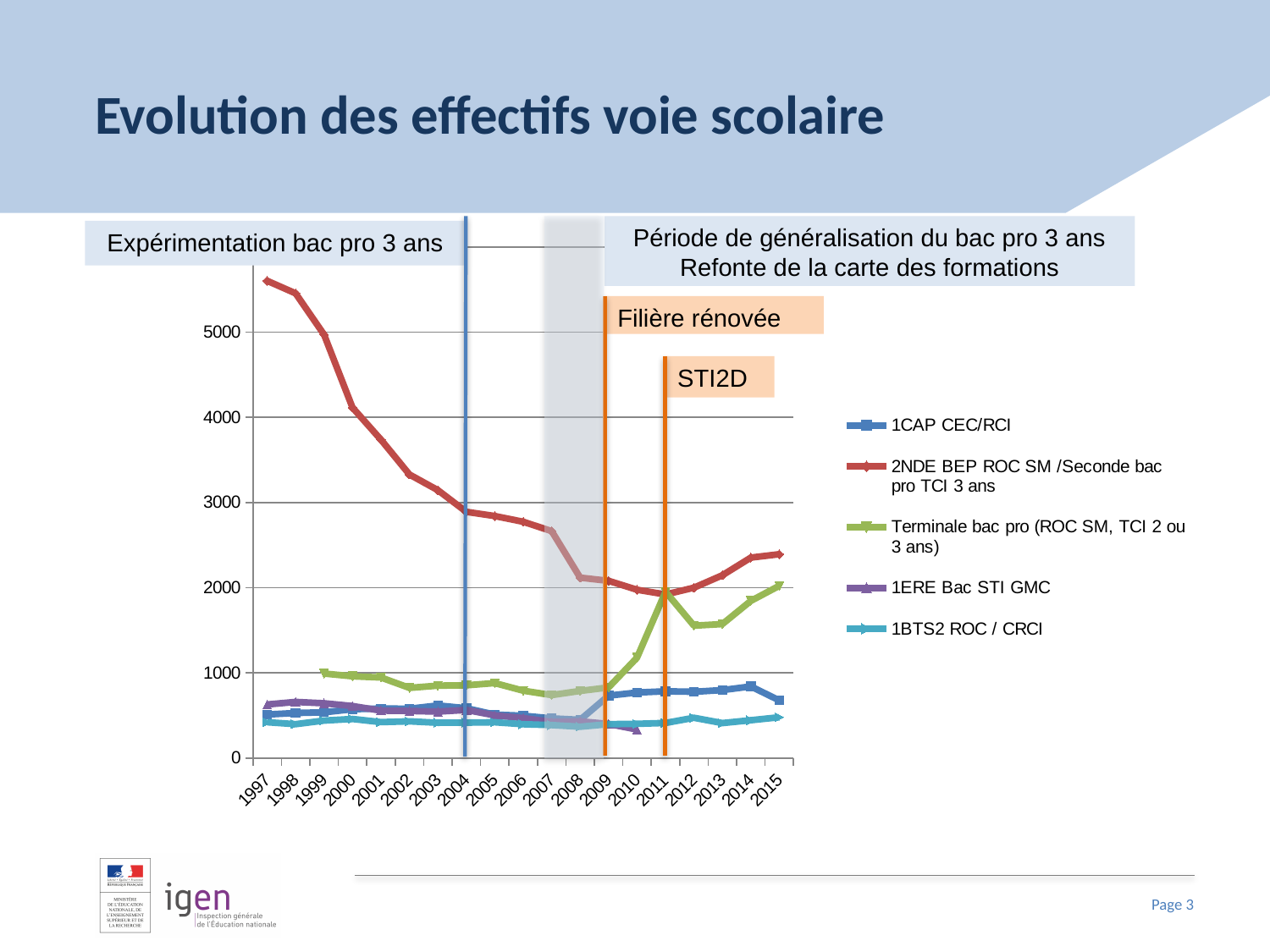
Is the value for 2NDE BEP ROC SM /Seconde bac pro TCI 3 ans in 2002 greater or less than 3000? greater In which year does the 2NDE BEP ROC SM /Seconde bac pro TCI 3 ans series reach its highest value? 1997 Is the value for 2NDE BEP ROC SM /Seconde bac pro TCI 3 ans in 1997 greater or less than 5000? greater How many series does the chart legend list? 5 Which legend entry is drawn in purple? 1ERE Bac STI GMC Which series has the highest value in 1997? 2NDE BEP ROC SM /Seconde bac pro TCI 3 ans Does the 2NDE BEP ROC SM /Seconde bac pro TCI 3 ans series rise or fall between 1997 and 2011? fall How many years are shown along the x axis of the chart? 19 Is the value for Terminale bac pro (ROC SM, TCI 2 ou 3 ans) in 2012 greater or less than 2000? less What kind of chart is shown on the slide? line chart In 2013, which is higher: Terminale bac pro (ROC SM, TCI 2 ou 3 ans) or 1CAP CEC/RCI? Terminale bac pro (ROC SM, TCI 2 ou 3 ans) What is the title of the slide containing the chart? Evolution des effectifs voie scolaire